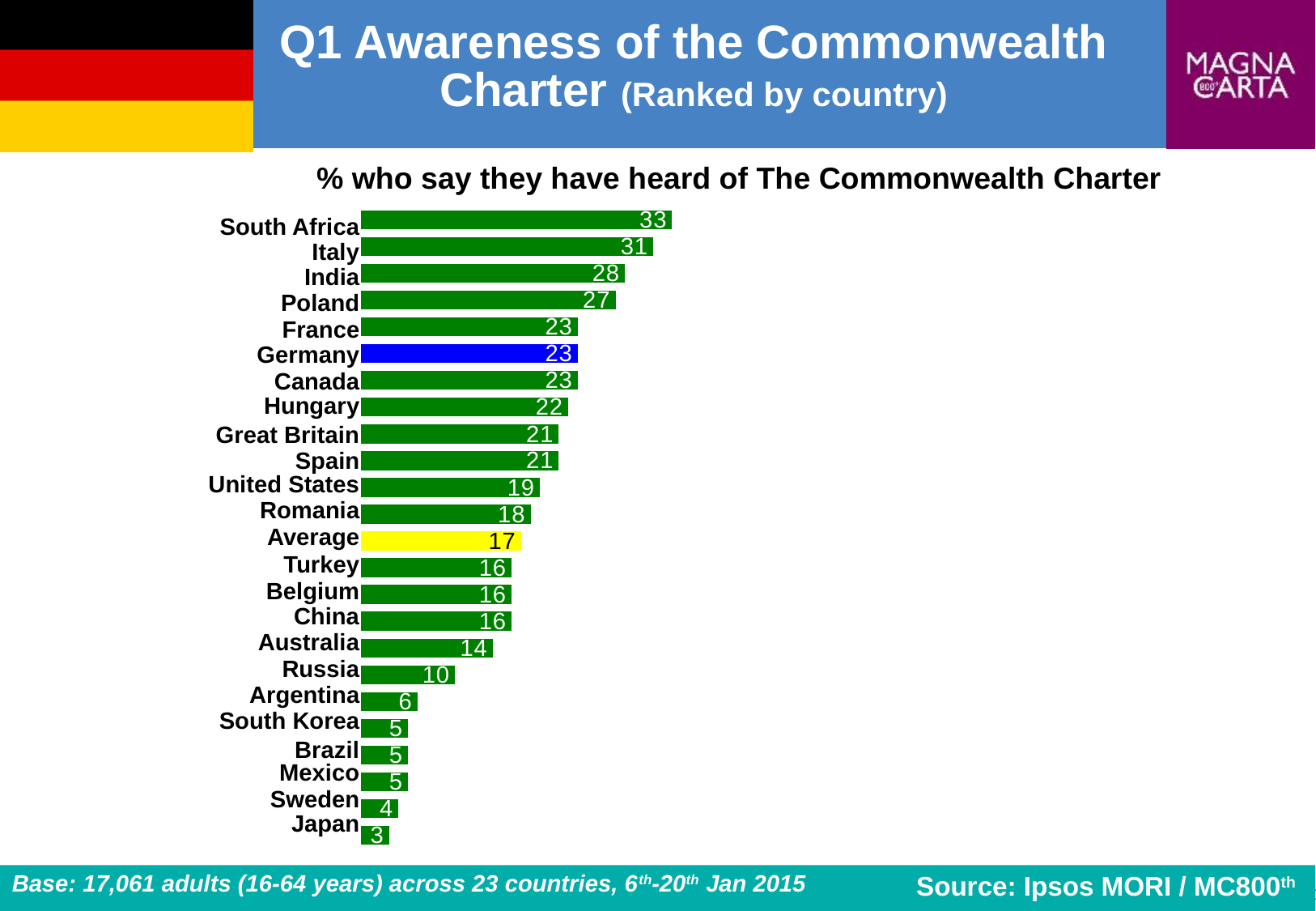
What kind of chart is shown on the slide? Bar chart What is the difference between the values for Germany and the Average? 6 Which bar is coloured blue? Germany Which has a larger value, Australia or Russia? Australia Which has a larger value, India or Poland? India What is the value for the Average bar? 17 Which country has the lowest value? Japan What is the value for Germany? 23 Which country has the highest value? South Africa What is the value for Russia? 10 How many bars are shown in the chart, including the Average bar? 24 What is the difference between the values for South Africa and Italy? 2